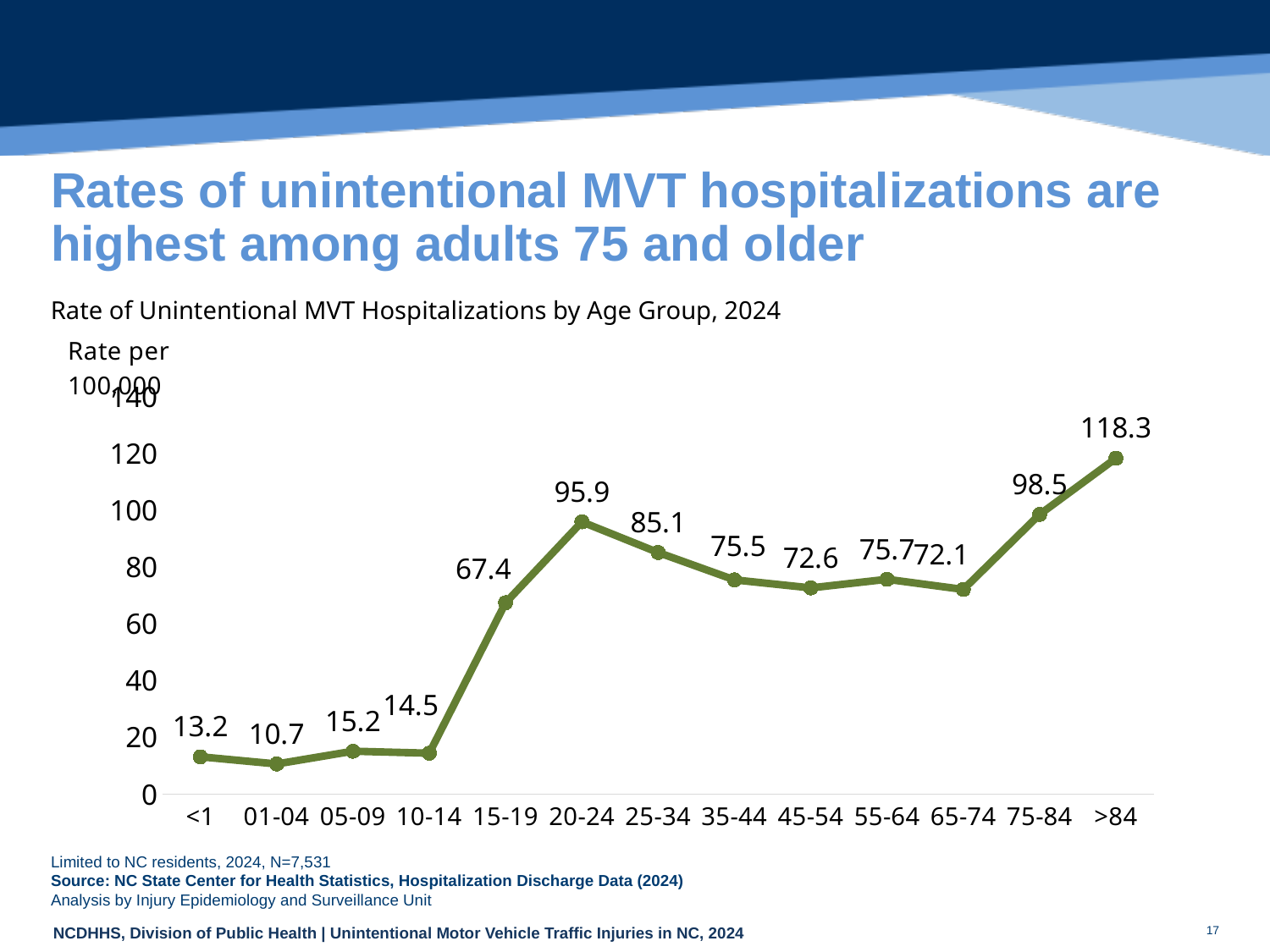
Which age group has the highest rate of unintentional MVT hospitalizations? >84 Does the rate rise or fall from the 65-74 age group to the >84 age group? Rise What kind of chart is shown on the slide? Line chart What is the difference between the rates for the >84 and 75-84 age groups? 19.8 What is the rate for the 15-19 age group? 67.4 How many age groups are plotted on the chart? 13 What is the rate for the >84 age group? 118.3 Which age group has the lowest rate of unintentional MVT hospitalizations? 01-04 What is the title of the chart? Rate of Unintentional MVT Hospitalizations by Age Group, 2024 Is the rate for the 65-74 age group greater or less than 80? less Which age group has a higher rate, 25-34 or 35-44? 25-34 What is the rate of unintentional MVT hospitalizations for the 20-24 age group? 95.9